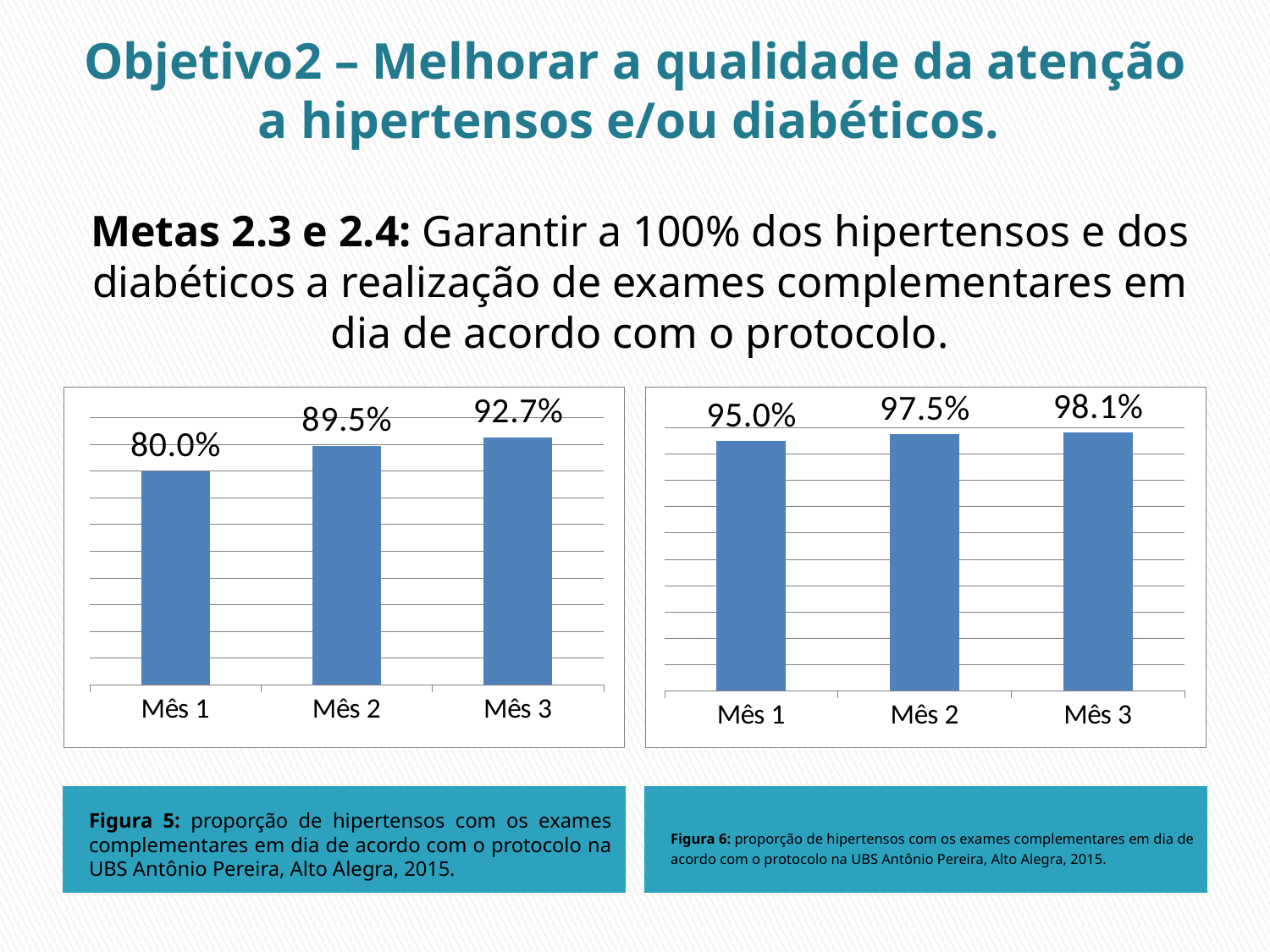
How many months are shown in the left chart (Figura 5)? 3 In the right chart (Figura 6), what is the value for Mês 3? 98.1% In the left chart (Figura 5), what is the value for Mês 3? 92.7% In the right chart (Figura 6), which month has the highest value? Mês 3 In the right chart (Figura 6), what is the difference between the values for Mês 3 and Mês 1? 3.1% In the left chart (Figura 5), what is the value for Mês 1? 80.0% In the left chart (Figura 5), do the values rise or fall from Mês 1 to Mês 3? Rise In the left chart (Figura 5), which month has the lowest value? Mês 1 What type of chart is the right chart (Figura 6)? Bar chart In the right chart (Figura 6), what is the value for Mês 2? 97.5% In the left chart (Figura 5), what is the difference between the values for Mês 2 and Mês 1? 9.5% Which is larger: the Mês 1 value in the left chart (Figura 5) or the Mês 1 value in the right chart (Figura 6)? Right chart (Figura 6)